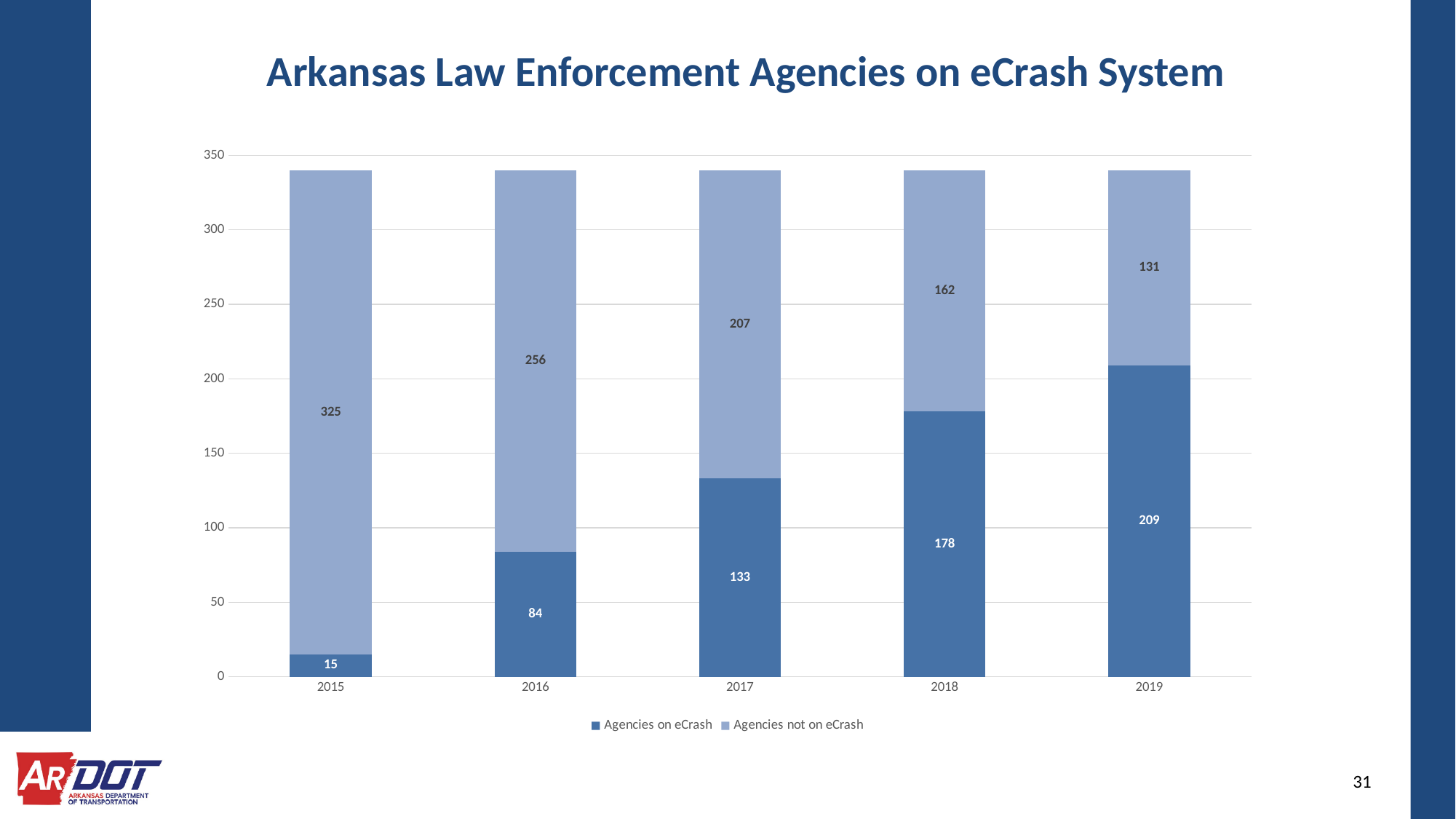
How many agencies were not on eCrash in 2015? 325 What kind of chart is shown on the slide? Stacked bar chart What is the title of the chart? Arkansas Law Enforcement Agencies on eCrash System In which year was the number of agencies not on eCrash lowest? 2019 What is the difference between the number of agencies on eCrash in 2019 and in 2015? 194 In which year was the number of agencies on eCrash highest? 2019 How many agencies were on eCrash in 2017? 133 How many years are shown on the x axis? 5 What is the total number of agencies in the 2016 bar? 340 Does the number of agencies on eCrash rise or fall from 2015 to 2019? Rise How many series does the legend list? 2 Which is larger in 2018: agencies on eCrash or agencies not on eCrash? Agencies on eCrash